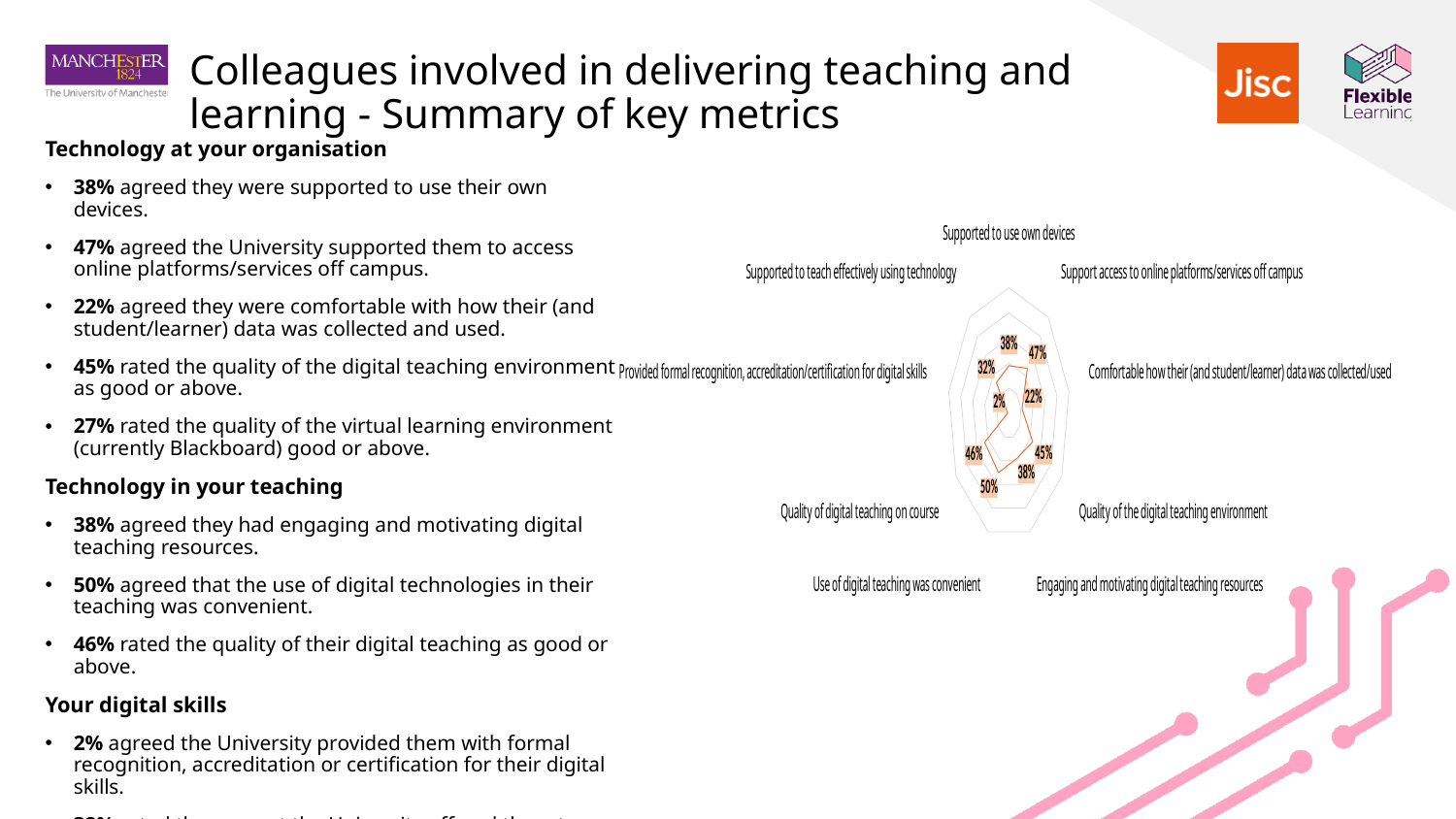
What is the value for 'Supported to use own devices' on the radar chart? 38% What is the value for 'Supported to teach effectively using technology' on the radar chart? 32% Which is larger on the radar chart: the value for 'Quality of digital teaching on course' or the value for 'Supported to teach effectively using technology'? Quality of digital teaching on course What is the difference between the values for 'Support access to online platforms/services off campus' and 'Comfortable how their (and student/learner) data was collected/used' on the radar chart? 25% Which category has the highest value on the radar chart? Use of digital teaching was convenient What kind of chart is shown on the slide? Radar chart Which category has the lowest value on the radar chart? Provided formal recognition, accreditation/certification for digital skills What is the value for 'Use of digital teaching was convenient' on the radar chart? 50% What is the difference between the values for 'Use of digital teaching was convenient' and 'Engaging and motivating digital teaching resources' on the radar chart? 12% What is the value for 'Provided formal recognition, accreditation/certification for digital skills' on the radar chart? 2% How many categories are plotted on the radar chart? 9 What is the value for 'Support access to online platforms/services off campus' on the radar chart? 47%